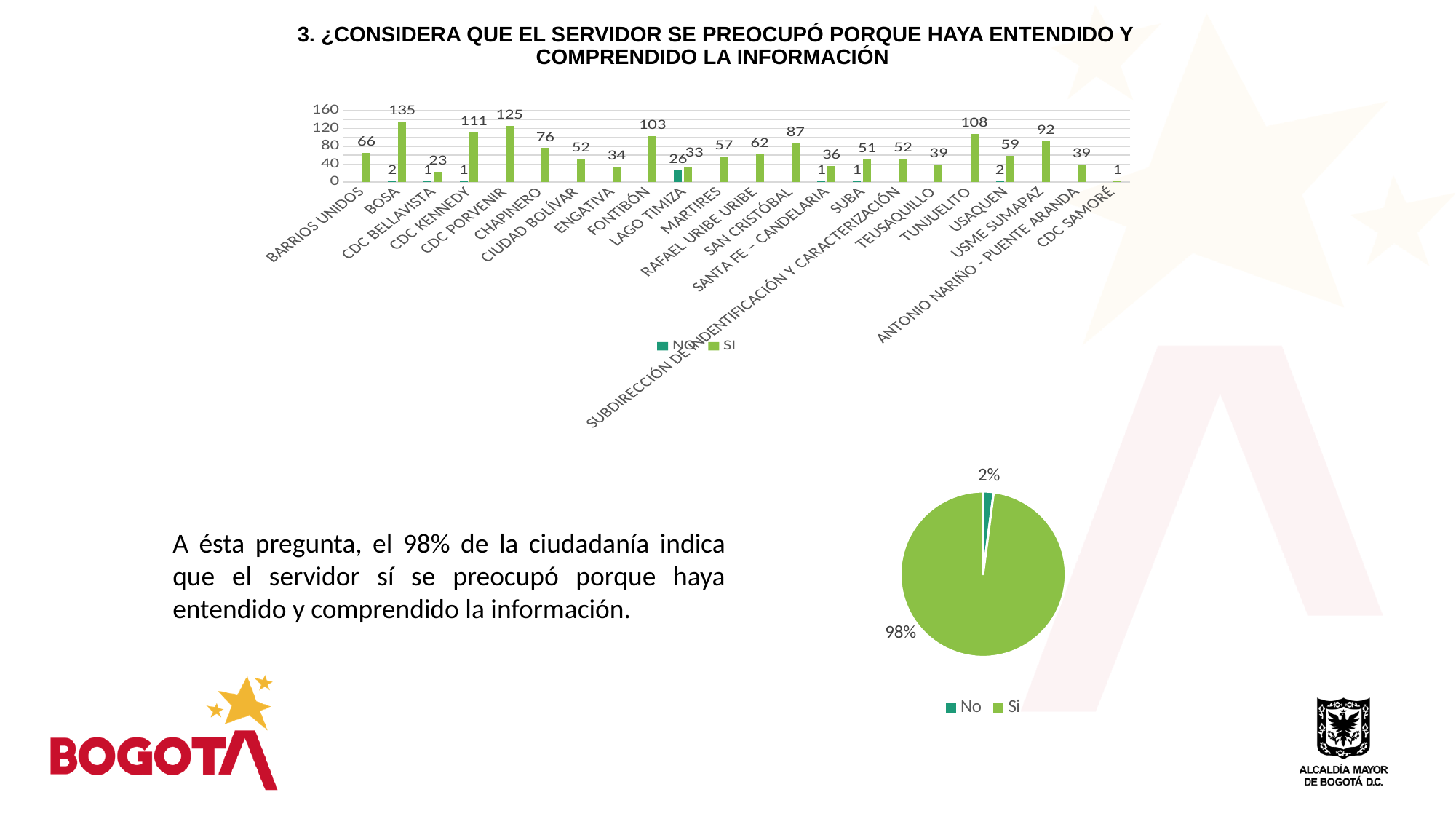
In the bar chart, which has a larger SI value, TUNJUELITO or USME SUMAPAZ? TUNJUELITO In the pie chart, what share is labelled for Si? 98% In the bar chart, what is the SI value for CDC SAMORÉ? 1 What kind of chart is the chart at the bottom right of the slide? Pie chart How many series does the legend of the bar chart list? 2 What kind of chart is the top chart on the slide? Bar chart In the pie chart, what share is labelled for No? 2% In the bar chart, what is the SI value for FONTIBÓN? 103 In the bar chart, what is the SI value for BOSA? 135 In the bar chart, what is the difference between the SI values for CDC PORVENIR and CDC KENNEDY? 14 In the bar chart, which category has the highest SI value? BOSA In the bar chart, what is the NO value for LAGO TIMIZA? 26